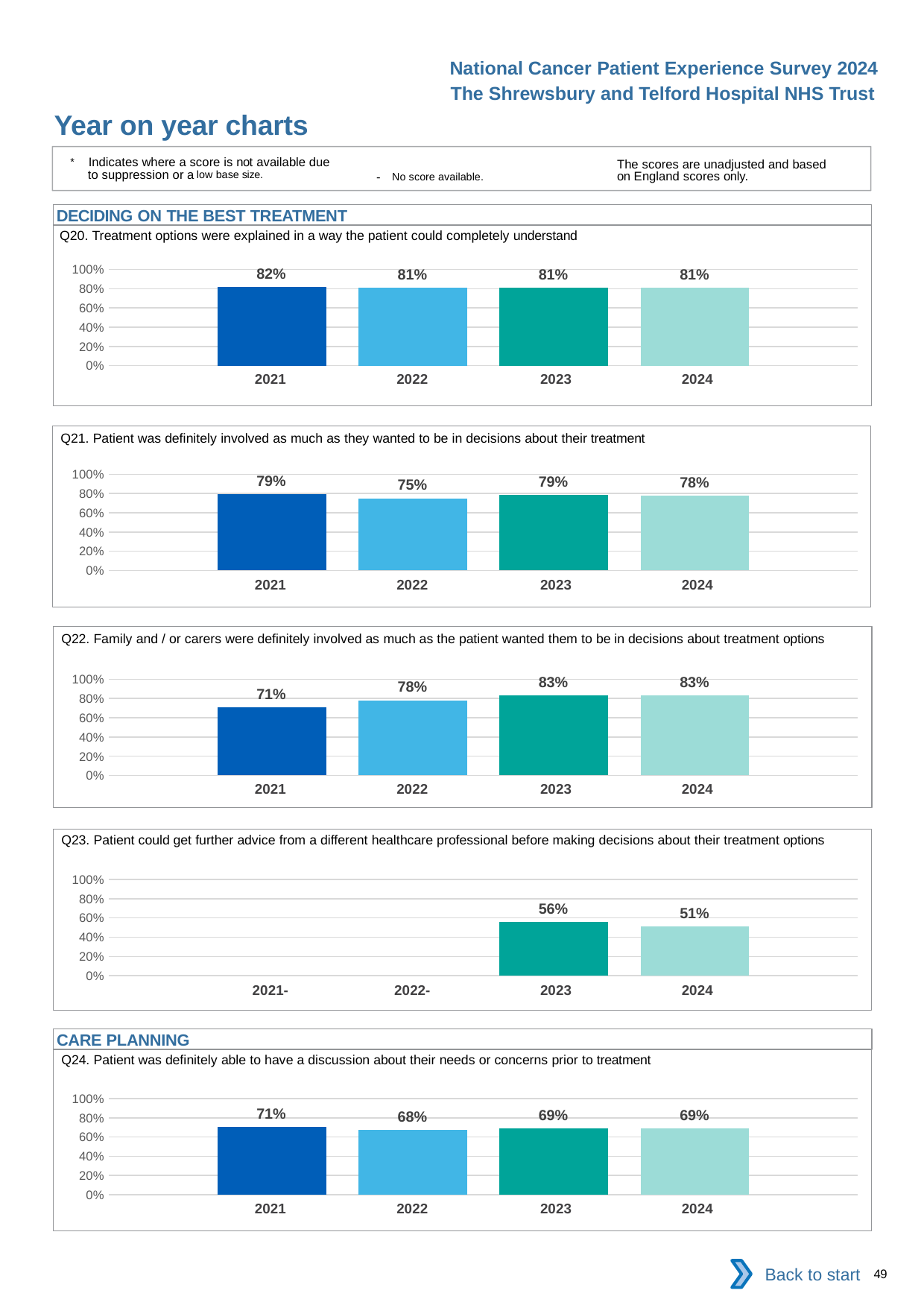
In the Q23 chart, which is larger, the value for 2023 or 2024? 2023 In the Q24 chart, what is the value for 2022? 68% In the Q22 chart, what is the value for 2024? 83% In the Q24 chart, which year has the highest value? 2021 In the Q22 chart, which year has the lowest value? 2021 In the Q23 chart, what is the difference between the 2023 and 2024 values? 5% In the Q23 chart, how many years have a bar plotted? 2 What kind of chart is used for Q20? bar chart In the Q22 chart, do the values rise or fall from 2021 to 2023? rise In the Q21 chart, what is the difference between the 2021 and 2022 values? 4% In the Q20 chart, what is the value for 2021? 82% In the Q21 chart, which year has the lowest value? 2022